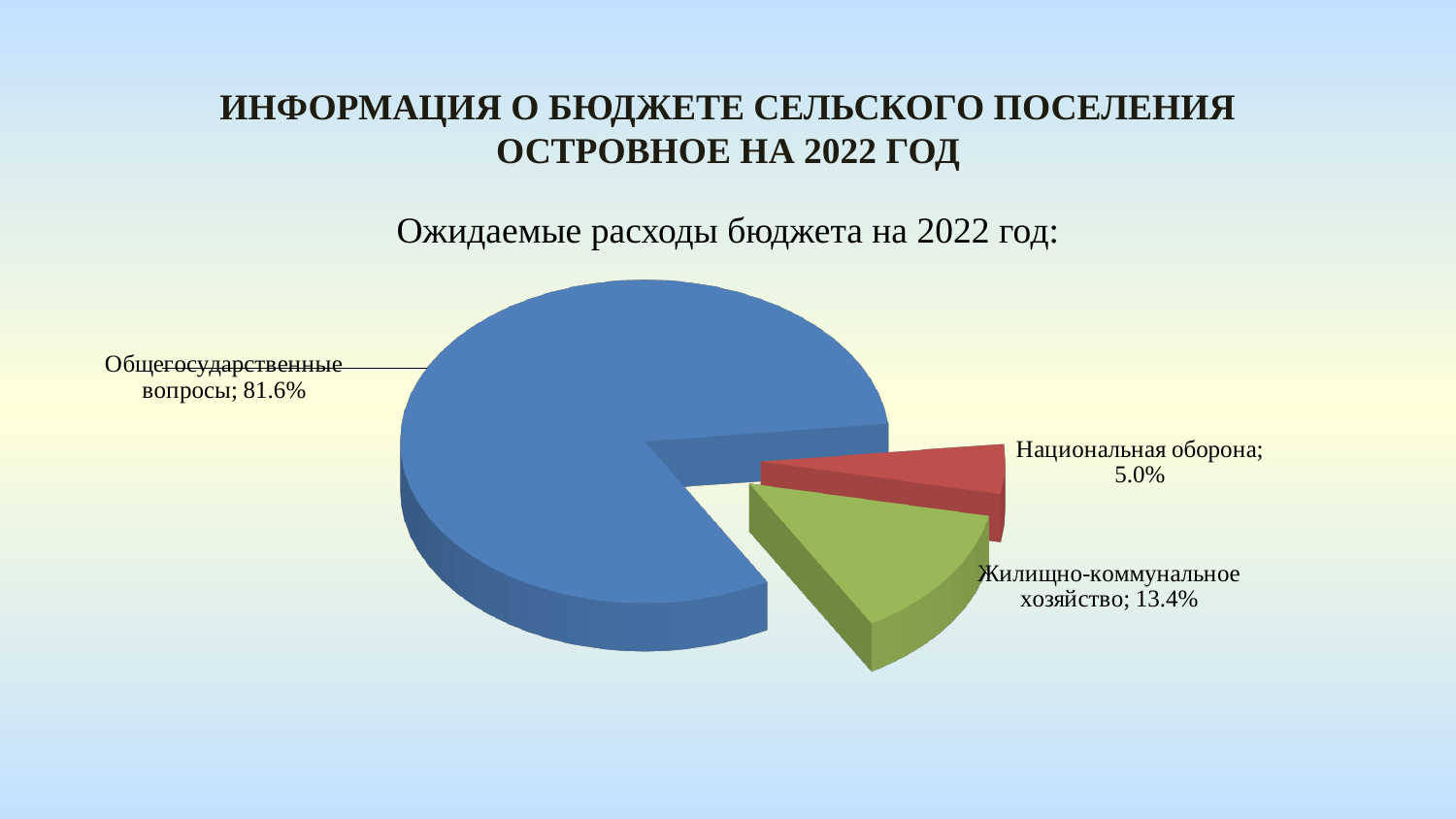
What colour is the slice for Национальная оборона? red What kind of chart is shown on the slide? pie chart Which is larger: the share for Жилищно-коммунальное хозяйство or the share for Национальная оборона? Жилищно-коммунальное хозяйство What is the difference in percentage points between Общегосударственные вопросы and Жилищно-коммунальное хозяйство? 68.2 How many categories (slices) does the pie chart have? 3 Which category has the smallest share of the pie? Национальная оборона Which category has the largest share of the pie? Общегосударственные вопросы What share of the expected 2022 budget expenditures goes to Национальная оборона? 5.0% What share of the expected 2022 budget expenditures goes to Жилищно-коммунальное хозяйство? 13.4% What is the difference in percentage points between Жилищно-коммунальное хозяйство and Национальная оборона? 8.4 What is the title of the chart? Ожидаемые расходы бюджета на 2022 год: What share of the expected 2022 budget expenditures goes to Общегосударственные вопросы? 81.6%